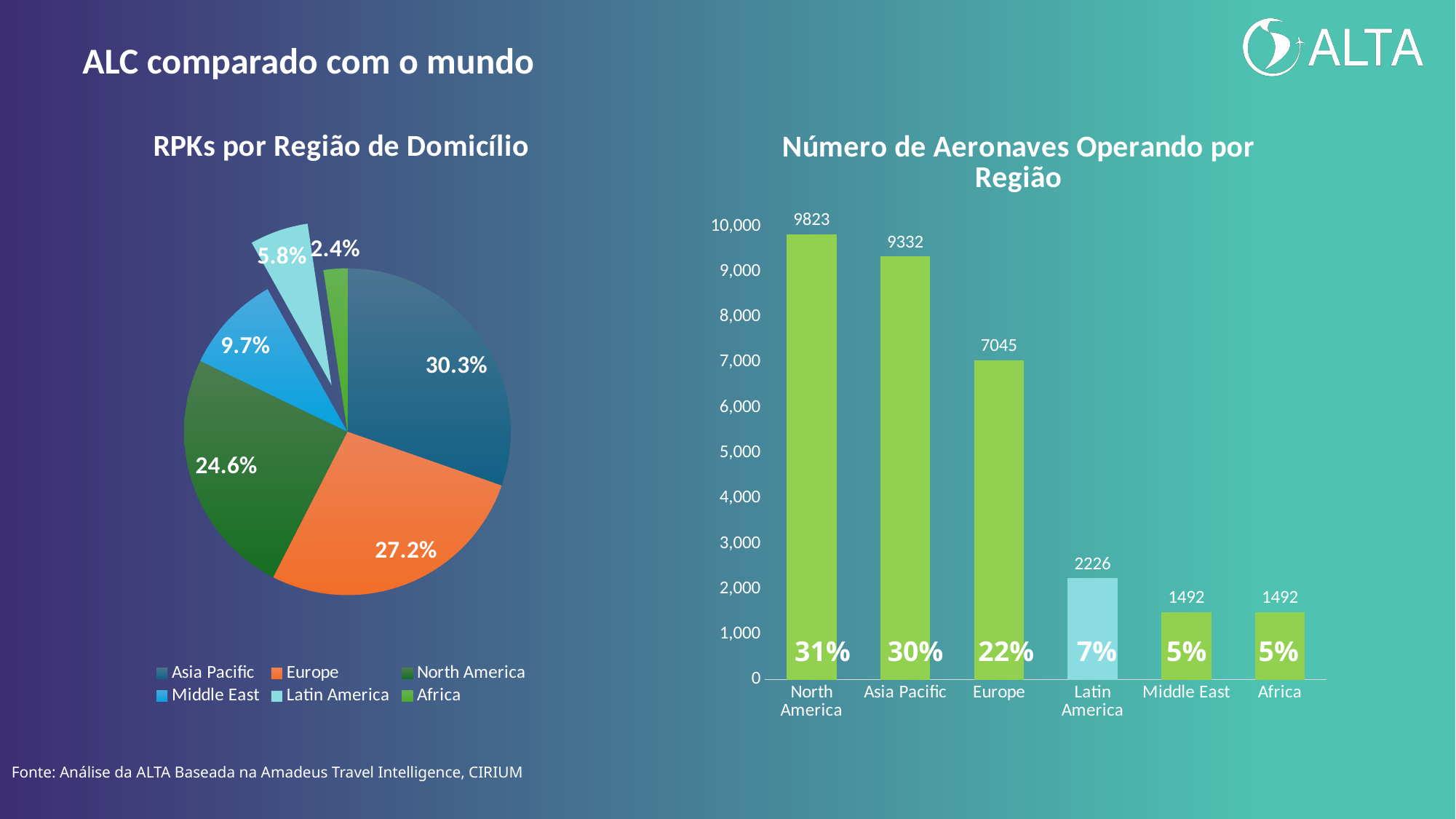
In the chart 'Número de Aeronaves Operando por Região', what is the value for Latin America? 2226 What kind of chart is 'RPKs por Região de Domicílio'? Pie chart In the chart 'Número de Aeronaves Operando por Região', what is the value for Europe? 7045 In the chart 'RPKs por Região de Domicílio', which region has the smallest slice? Africa In the chart 'RPKs por Região de Domicílio', what share does Latin America have? 5.8% In the chart 'Número de Aeronaves Operando por Região', which region has the highest number of aircraft? North America What kind of chart is 'Número de Aeronaves Operando por Região'? Bar chart In the chart 'Número de Aeronaves Operando por Região', what is the difference between North America and Asia Pacific? 491 In the chart 'RPKs por Região de Domicílio', which region has the largest slice? Asia Pacific In the chart 'RPKs por Região de Domicílio', what share does Asia Pacific have? 30.3% In the chart 'Número de Aeronaves Operando por Região', what percentage label is shown on the Latin America bar? 7% In the chart 'RPKs por Região de Domicílio', how many regions does the legend list? 6